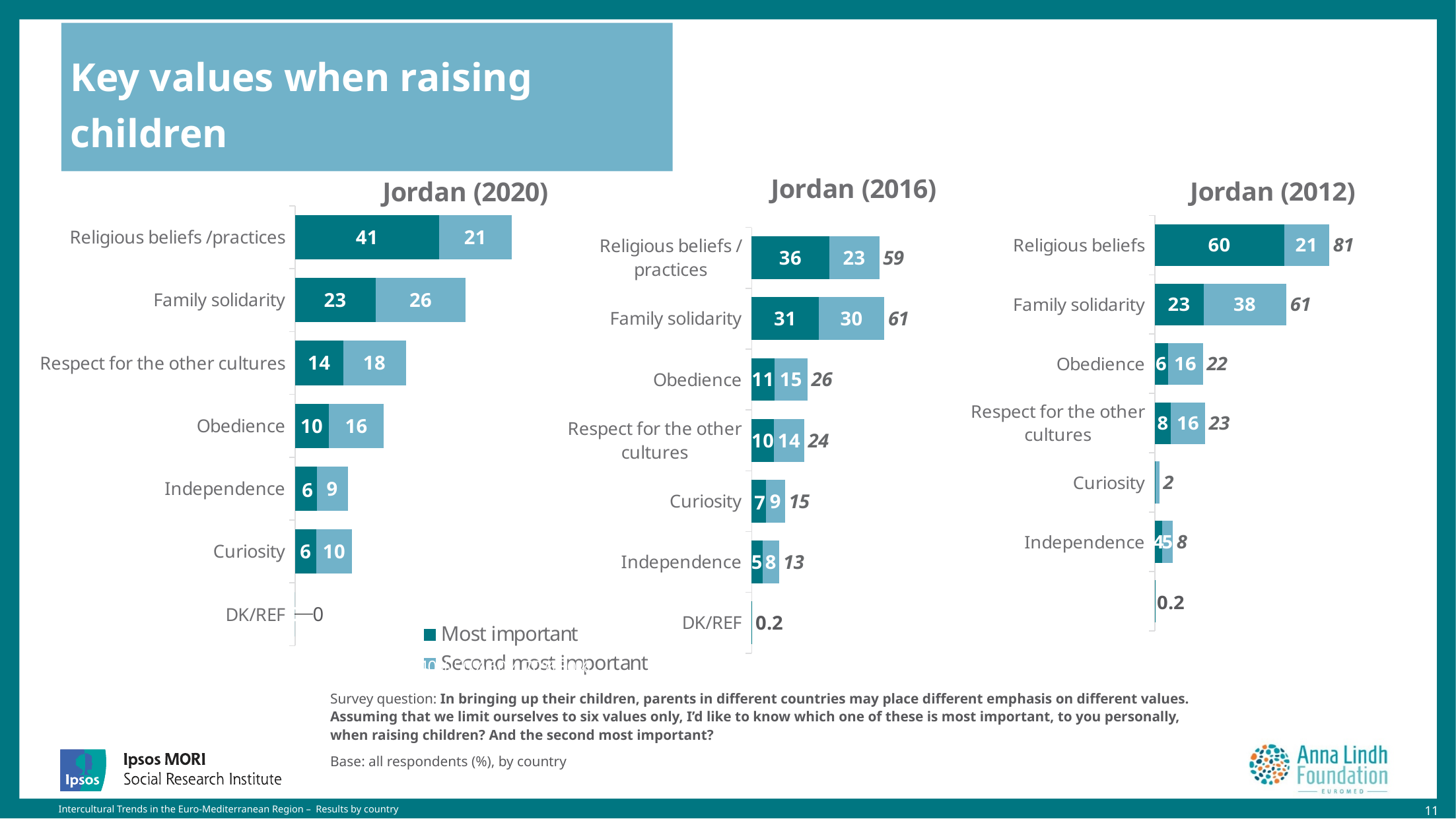
In the Jordan (2012) chart, what is the difference between the totals for Religious beliefs and Family solidarity? 20 In the Jordan (2020) chart, which category has the highest 'Most important' value? Religious beliefs /practices In the Jordan (2020) chart, what is the total of the stacked bar for Respect for the other cultures? 32 How many series does the legend list? 2 In the Jordan (2020) chart, what is the 'Second most important' value for Family solidarity? 26 What type of chart is the Jordan (2020) chart? Stacked bar chart In the Jordan (2012) chart, what is the 'Most important' value for Religious beliefs? 60 In the Jordan (2016) chart, which has the larger total, Religious beliefs / practices or Family solidarity? Family solidarity In the Jordan (2012) chart, what is the total shown for Obedience? 22 In the Jordan (2016) chart, what is the difference between the 'Most important' values for Obedience and Independence? 6 In the Jordan (2020) chart, what is the 'Most important' value for Religious beliefs /practices? 41 In the Jordan (2016) chart, what is the total shown for Family solidarity? 61